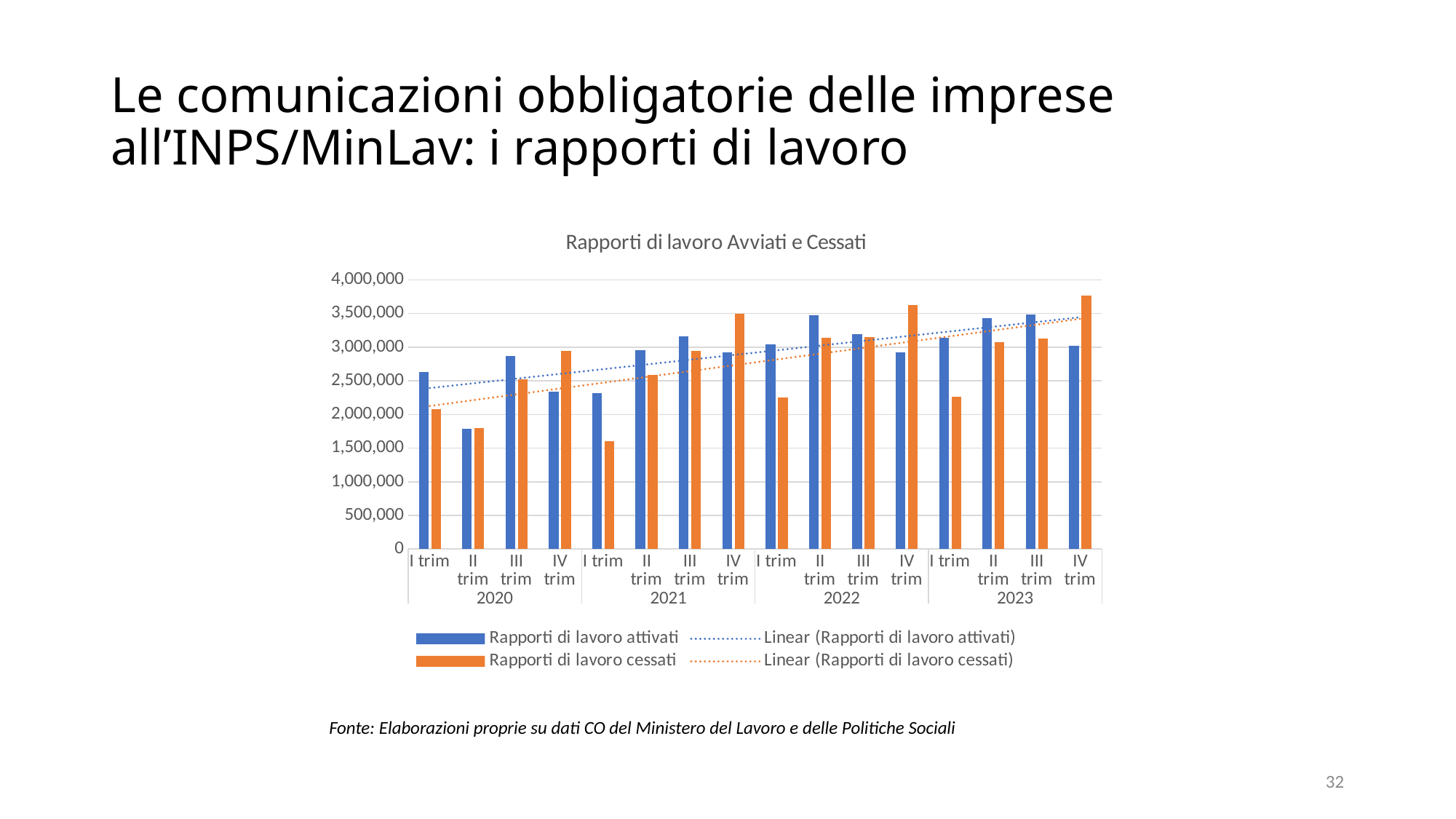
In IV trim 2021, which is larger: Rapporti di lavoro attivati or Rapporti di lavoro cessati? Rapporti di lavoro cessati What is the title of the chart? Rapporti di lavoro Avviati e Cessati How many entries does the chart legend list? 4 In which quarter is the value for Rapporti di lavoro cessati the lowest? I trim 2021 Is the value for Rapporti di lavoro attivati in II trim 2022 greater or less than 3,000,000? greater In which quarter is the value for Rapporti di lavoro cessati the highest? IV trim 2023 Is the value for Rapporti di lavoro cessati in IV trim 2023 greater or less than 3,500,000? greater Is the value for Rapporti di lavoro cessati in I trim 2021 greater or less than 2,000,000? less Do the dotted linear trend lines rise or fall from 2020 to 2023? rise What kind of chart is shown on the slide? bar chart In which quarter is the value for Rapporti di lavoro attivati the lowest? II trim 2020 How many quarters (trimestri) are plotted along the x axis? 16